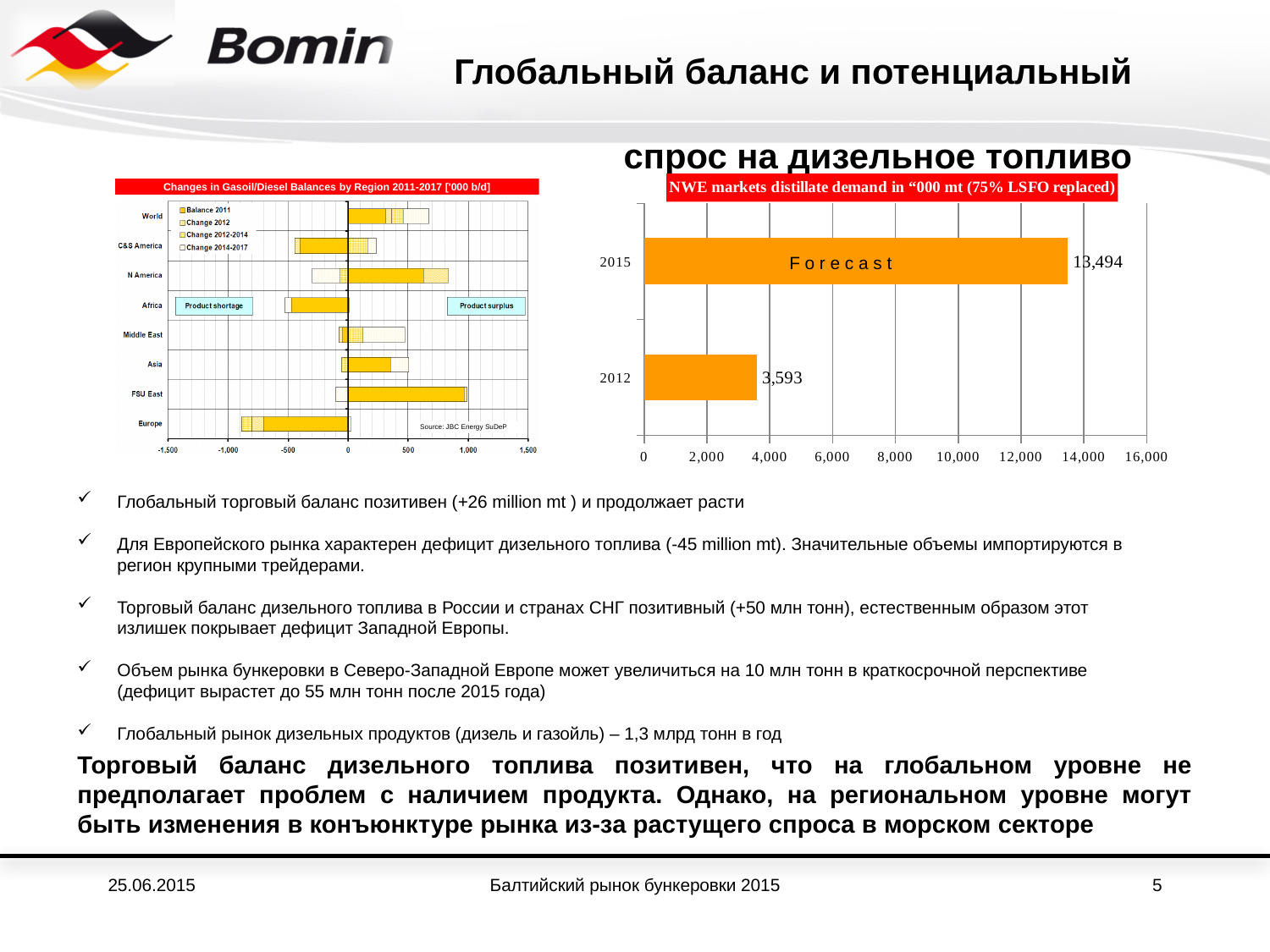
In the chart titled "NWE markets distillate demand", what is the difference between the 2015 and 2012 values? 9,901 In the chart titled "NWE markets distillate demand", which year has the higher value, 2012 or 2015? 2015 In the chart titled "Changes in Gasoil/Diesel Balances by Region 2011-2017", what source is cited at the bottom of the chart? JBC Energy SuDeP In the chart titled "Changes in Gasoil/Diesel Balances by Region 2011-2017", how many series does the legend list? 4 What kind of chart is the one titled "NWE markets distillate demand"? Bar chart In the chart titled "NWE markets distillate demand", what is the value for 2012? 3,593 In the chart titled "Changes in Gasoil/Diesel Balances by Region 2011-2017", how many regions are listed on the vertical axis? 8 In the chart titled "NWE markets distillate demand", what label is written inside the 2015 bar? Forecast In the chart titled "NWE markets distillate demand", how many years are plotted? 2 In the chart titled "NWE markets distillate demand", what is the value for 2015? 13,494 In the chart titled "Changes in Gasoil/Diesel Balances by Region 2011-2017", is the Balance 2011 value for FSU East greater or less than 500? greater In the chart titled "NWE markets distillate demand", is the value for 2012 greater or less than 4,000? less